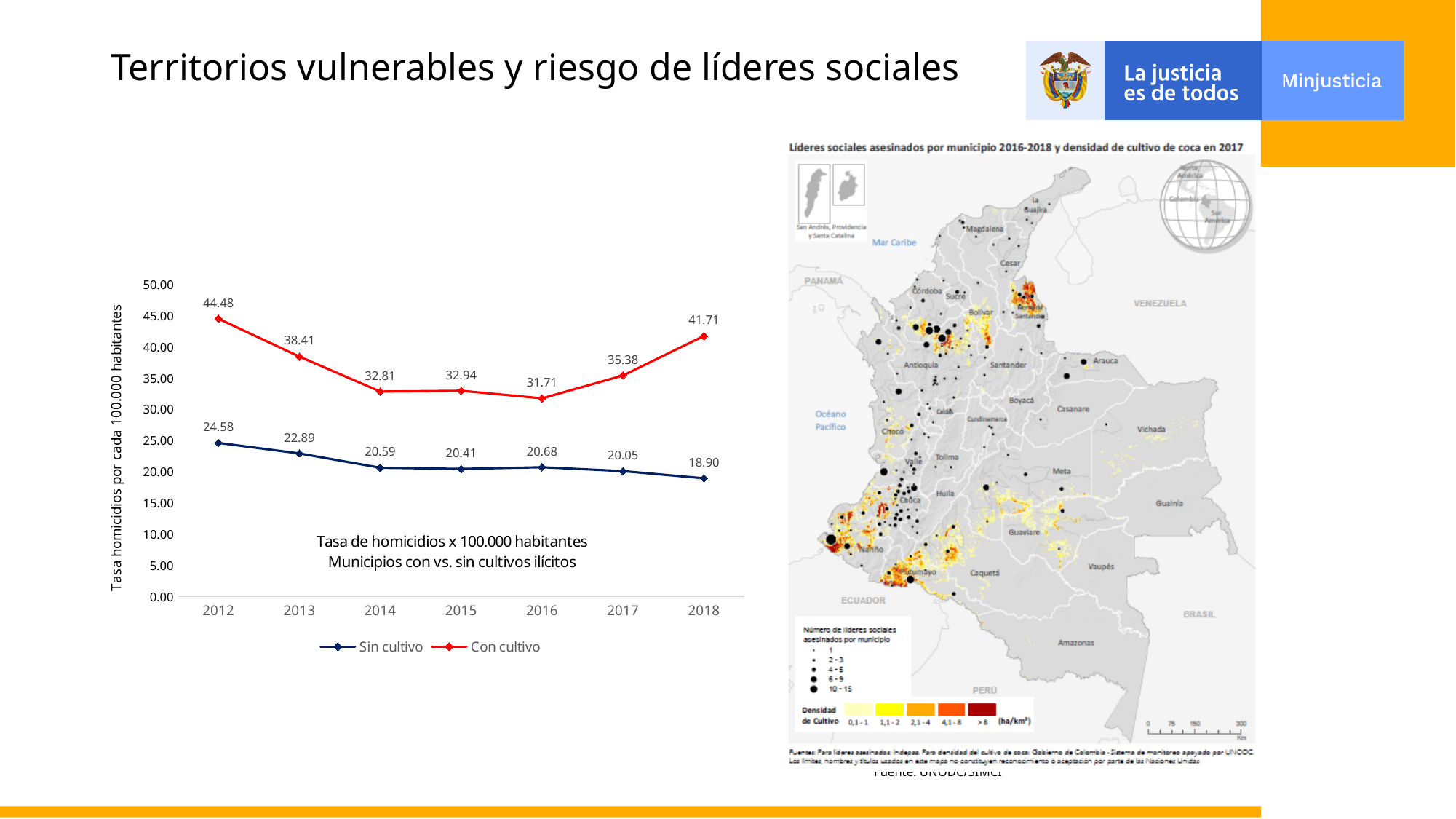
On the line chart, in which year is the Sin cultivo series highest? 2012 On the line chart, what is the value for Con cultivo in 2016? 31.71 On the line chart, what is the difference between the Con cultivo values for 2012 and 2018? 2.77 On the line chart, does the Sin cultivo series rise or fall from 2012 to 2018? Fall On the line chart, in which year is the Con cultivo series lowest? 2016 What kind of chart is the chart on the left of the slide? Line chart How many series does the legend of the line chart list? 2 How many years are shown on the x axis of the line chart? 7 On the line chart, what is the value for Con cultivo in 2012? 44.48 On the line chart, which series has the larger value in 2014, Sin cultivo or Con cultivo? Con cultivo On the line chart, what is the value for Sin cultivo in 2018? 18.90 On the line chart, what is the difference between Con cultivo and Sin cultivo in 2018? 22.81